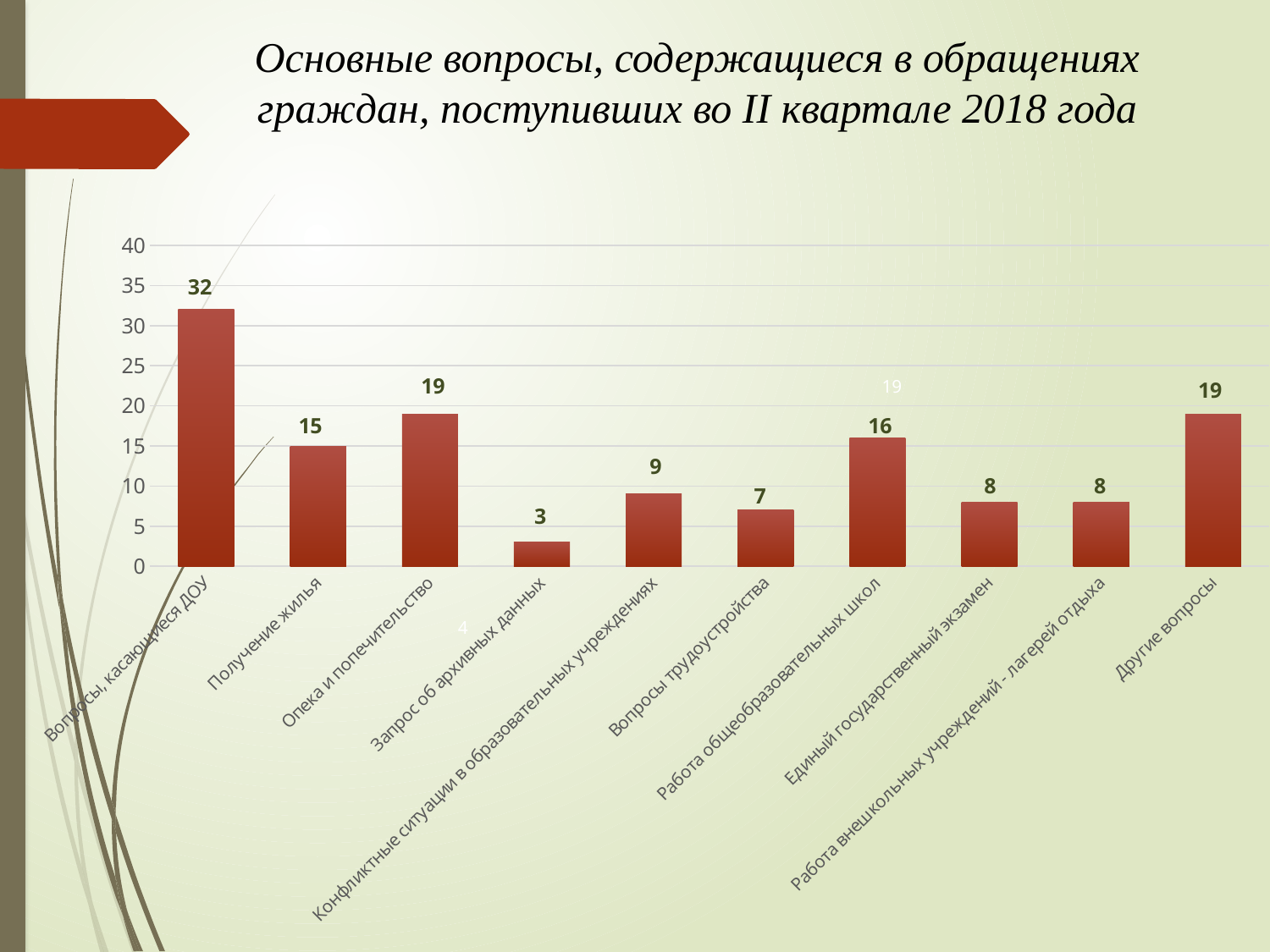
What type of chart is shown on the slide? bar chart What is the value for "Вопросы, касающиеся ДОУ"? 32 What is the value for "Запрос об архивных данных"? 3 What is the value for "Получение жилья"? 15 Which category has the lowest value? Запрос об архивных данных What is the title of the slide containing the chart? Основные вопросы, содержащиеся в обращениях граждан, поступивших во II квартале 2018 года What is the difference between the values for "Вопросы, касающиеся ДОУ" and "Получение жилья"? 17 Which category has the highest value? Вопросы, касающиеся ДОУ What is the value for "Работа общеобразовательных школ"? 16 How many categories are plotted in the chart? 10 Is the value for "Опека и попечительство" greater or less than 15? greater Which is larger: the value for "Вопросы трудоустройства" or the value for "Конфликтные ситуации в образовательных учреждениях"? Конфликтные ситуации в образовательных учреждениях